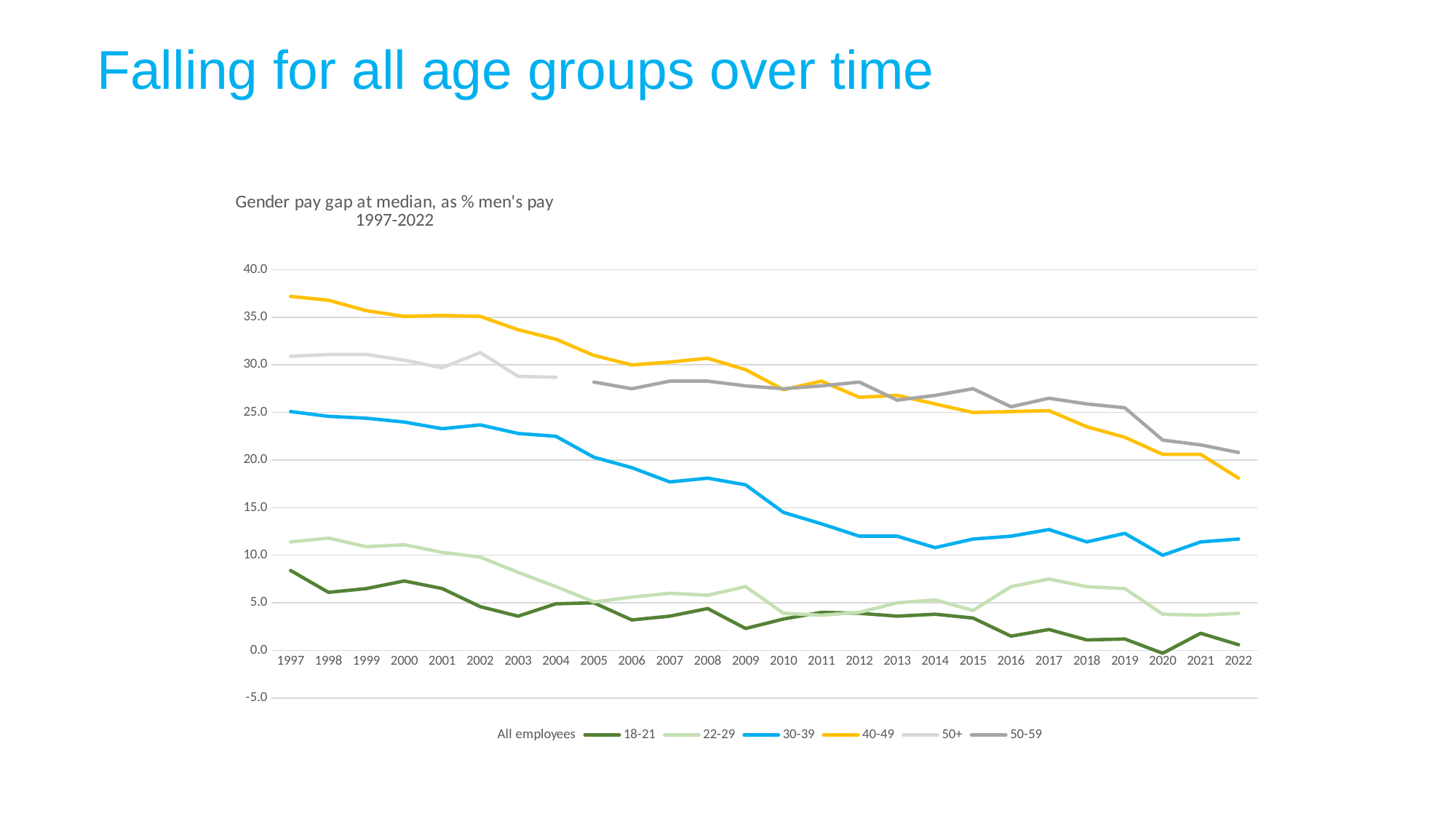
Which age group has the highest gender pay gap in 1997? 40-49 What kind of chart is shown on the slide? line chart Which age group has the highest gender pay gap in 2022? 50-59 In 2010, which has the larger gender pay gap: the 30-39 age group or the 22-29 age group? 30-39 Is the value for the 40-49 age group in 2022 greater or less than 20.0? less Which age group has the lowest gender pay gap in 1997? 18-21 How many years are shown along the x axis of the chart? 26 Does the gender pay gap for the 40-49 age group rise or fall from 1997 to 2022? fall What colour is the line for the 30-39 age group? blue Is the value for the 22-29 age group in 2022 greater or less than 5.0? less Is the value for the 40-49 age group in 1997 greater or less than 35.0? greater What is the title of the chart? Gender pay gap at median, as % men's pay 1997-2022